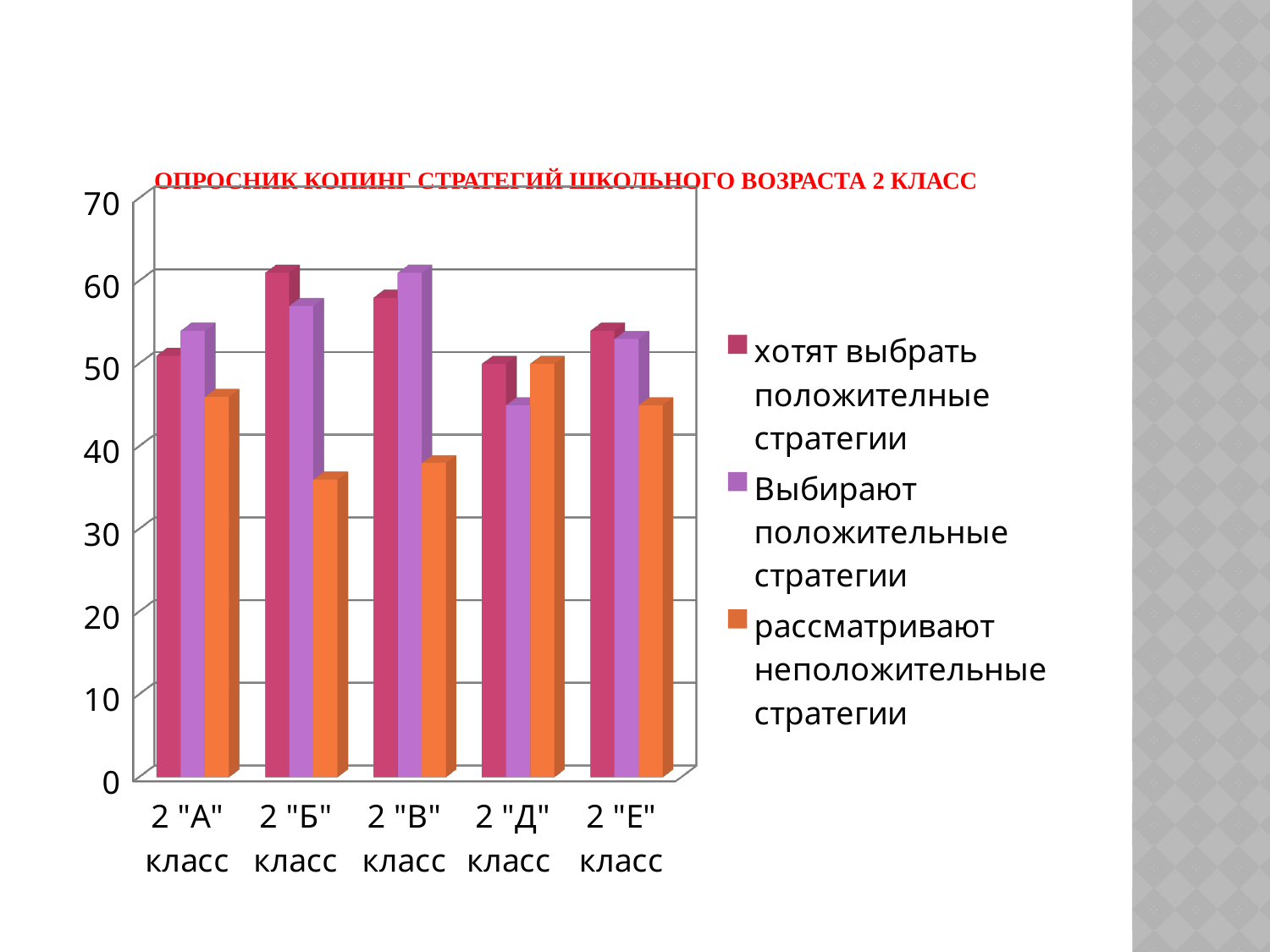
Is the value for "рассматривают неположительные стратегии" in 2 "Б" класс greater or less than 40? less What kind of chart is shown on the slide? bar chart How many series does the chart legend list? 3 Is the value for "Выбирают положительные стратегии" in 2 "Д" класс greater or less than 50? less Is the value for "хотят выбрать положителные стратегии" in 2 "Б" класс greater or less than 50? greater Which class has the highest value for "Выбирают положительные стратегии"? 2 "В" класс Which legend entry is shown in orange? рассматривают неположительные стратегии How many classes are shown along the x axis of the chart? 5 In 2 "Б" класс, which is larger: "хотят выбрать положителные стратегии" or "рассматривают неположительные стратегии"? хотят выбрать положителные стратегии What is the title of the chart? ОПРОСНИК КОПИНГ СТРАТЕГИЙ ШКОЛЬНОГО ВОЗРАСТА 2 КЛАСС Which class has the lowest value for "Выбирают положительные стратегии"? 2 "Д" класс